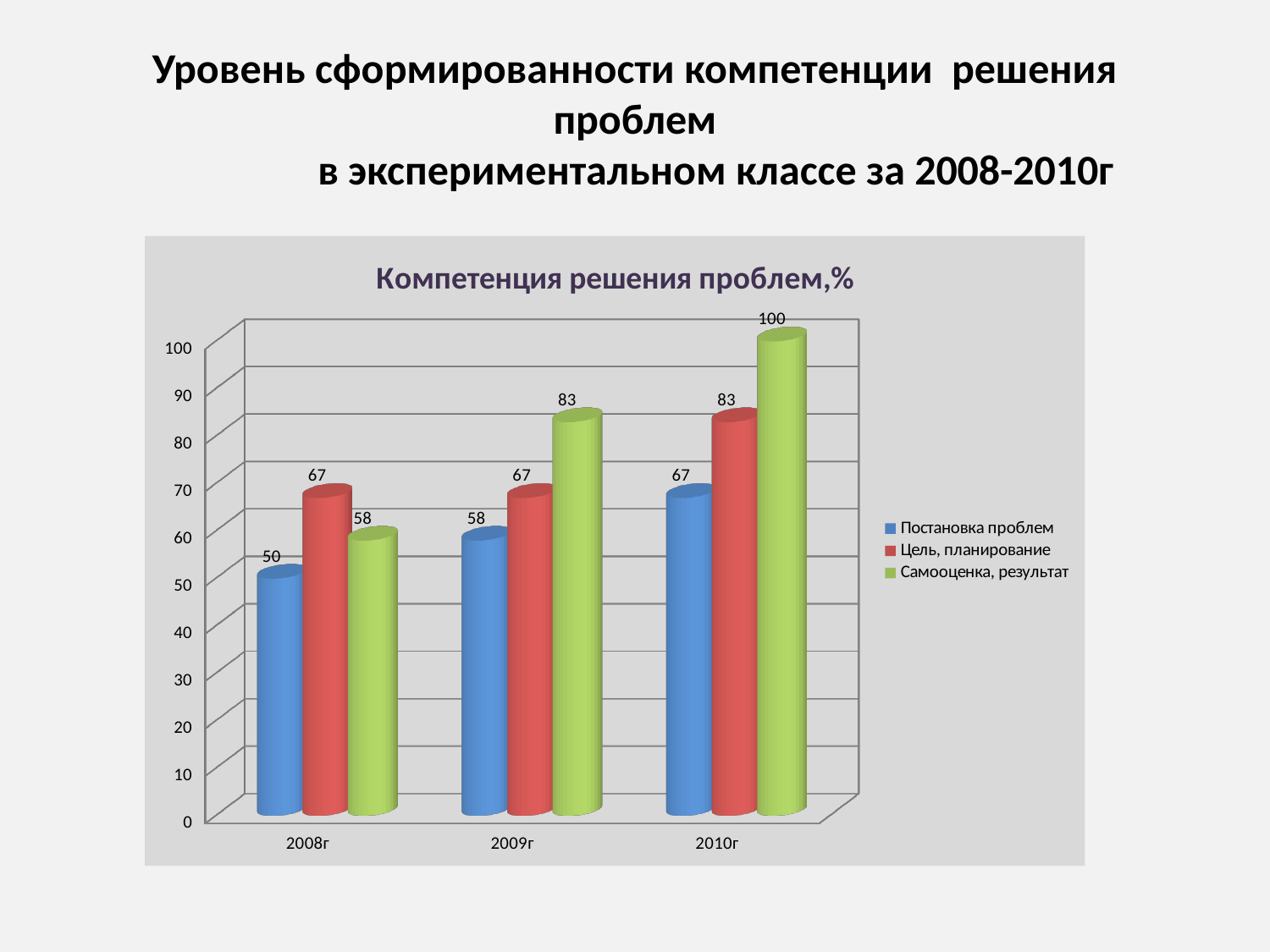
What is the value for Цель, планирование in 2009г? 67 What is the title of the chart? Компетенция решения проблем,% Do the values for Постановка проблем rise or fall from 2008г to 2010г? rise What is the value for Постановка проблем in 2008г? 50 Which is larger in 2009г: Цель, планирование or Самооценка, результат? Самооценка, результат What kind of chart is shown? bar chart Which year has the highest value for Самооценка, результат? 2010г Which year has the lowest value for Постановка проблем? 2008г What is the difference between Самооценка, результат in 2010г and in 2008г? 42 How many years are shown on the x axis? 3 How many series does the legend list? 3 What is the value for Самооценка, результат in 2010г? 100